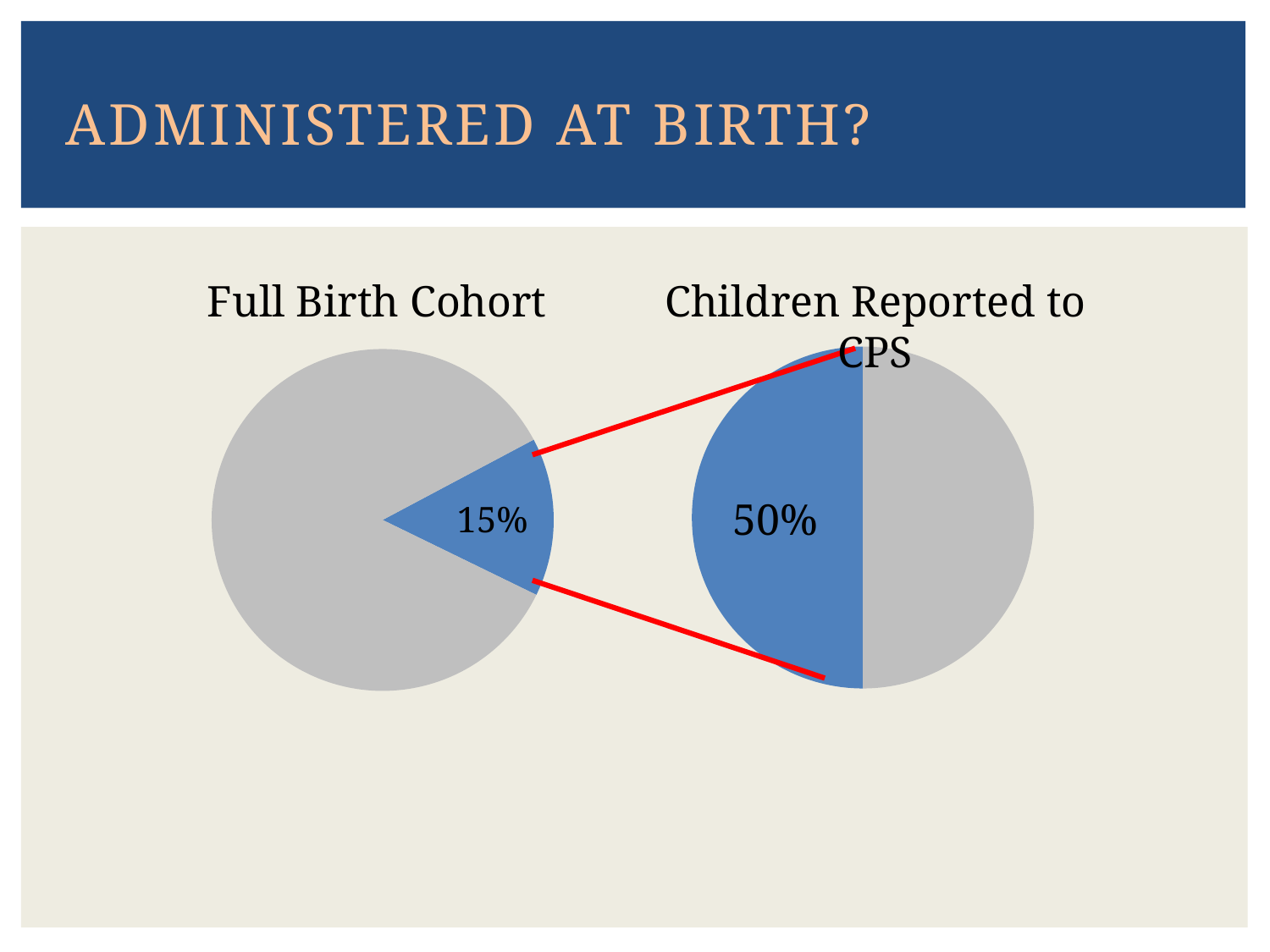
What is the title of the pie chart on the right of the slide? Children Reported to CPS What share of the "Children Reported to CPS" pie does the blue slice represent? 50% What share of the "Full Birth Cohort" pie does the blue slice represent? 15% How many slices does the "Children Reported to CPS" pie chart have? 2 What is the difference between the blue slice in the "Children Reported to CPS" chart and the blue slice in the "Full Birth Cohort" chart? 35 percentage points What kind of chart is the "Full Birth Cohort" chart? pie chart How many slices does the "Full Birth Cohort" pie chart have? 2 What is the title of the pie chart on the left of the slide? Full Birth Cohort In the "Children Reported to CPS" chart, what percentage is shown on the blue slice? 50% In the "Full Birth Cohort" chart, what percentage is shown on the blue slice? 15% Which chart has the larger blue slice, "Full Birth Cohort" or "Children Reported to CPS"? Children Reported to CPS What kind of chart is the "Children Reported to CPS" chart? pie chart